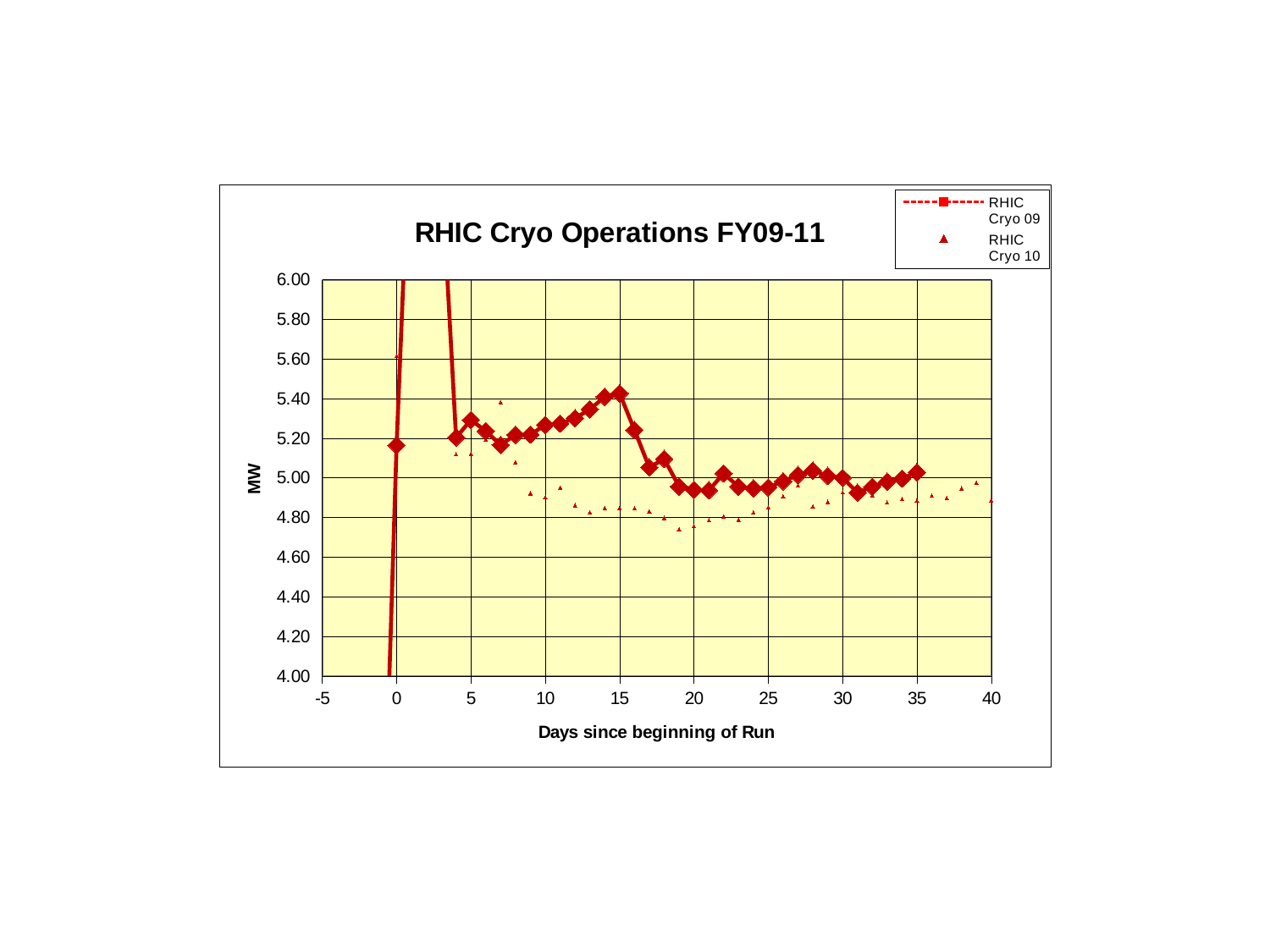
At day 10, which series has the larger value, RHIC Cryo 09 or RHIC Cryo 10? RHIC Cryo 09 How many series does the legend list? 2 What is the label of the x axis? Days since beginning of Run What is the title of the chart? RHIC Cryo Operations FY09-11 Does the RHIC Cryo 09 series rise or fall between day 15 and day 20? fall What kind of chart is shown on the slide? line chart At day 20, which series has the larger value, RHIC Cryo 09 or RHIC Cryo 10? RHIC Cryo 09 Is the value for RHIC Cryo 10 at day 20 greater or less than 4.80? less Is the value for RHIC Cryo 10 at day 10 greater or less than 5.00? less